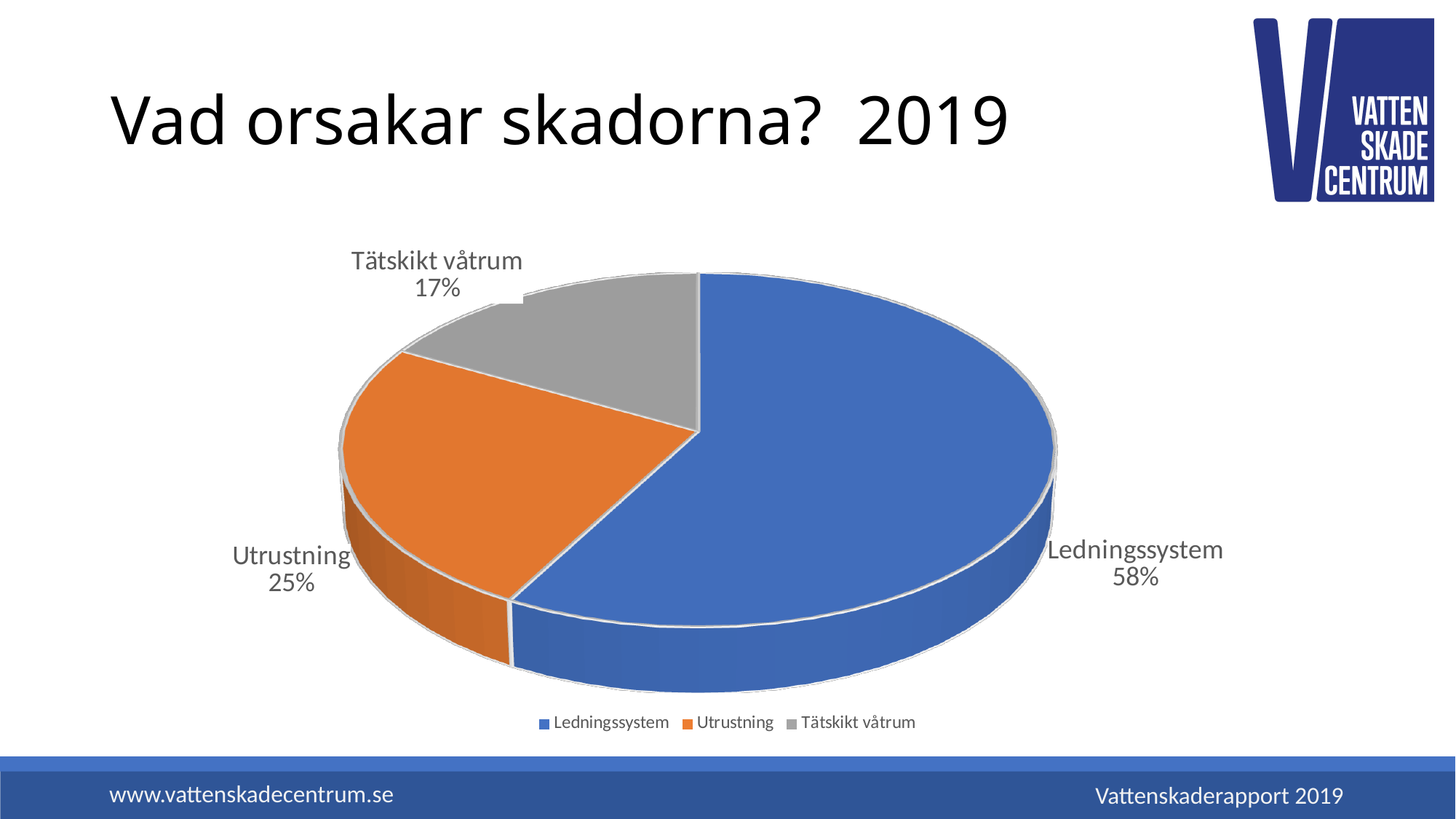
What share of the pie does Tätskikt våtrum account for? 17% How many categories are shown in the pie chart? 3 Which category has the largest slice of the pie? Ledningssystem What share of the pie does Ledningssystem account for? 58% What colour is the Utrustning slice? Orange What share of the pie does Utrustning account for? 25% What is the difference in percentage points between Ledningssystem and Utrustning? 33 Which is larger, the share for Utrustning or the share for Tätskikt våtrum? Utrustning What kind of chart is shown on the slide? Pie chart What is the title of the slide containing the chart? Vad orsakar skadorna? 2019 Which category has the smallest slice of the pie? Tätskikt våtrum What is the difference in percentage points between Utrustning and Tätskikt våtrum? 8